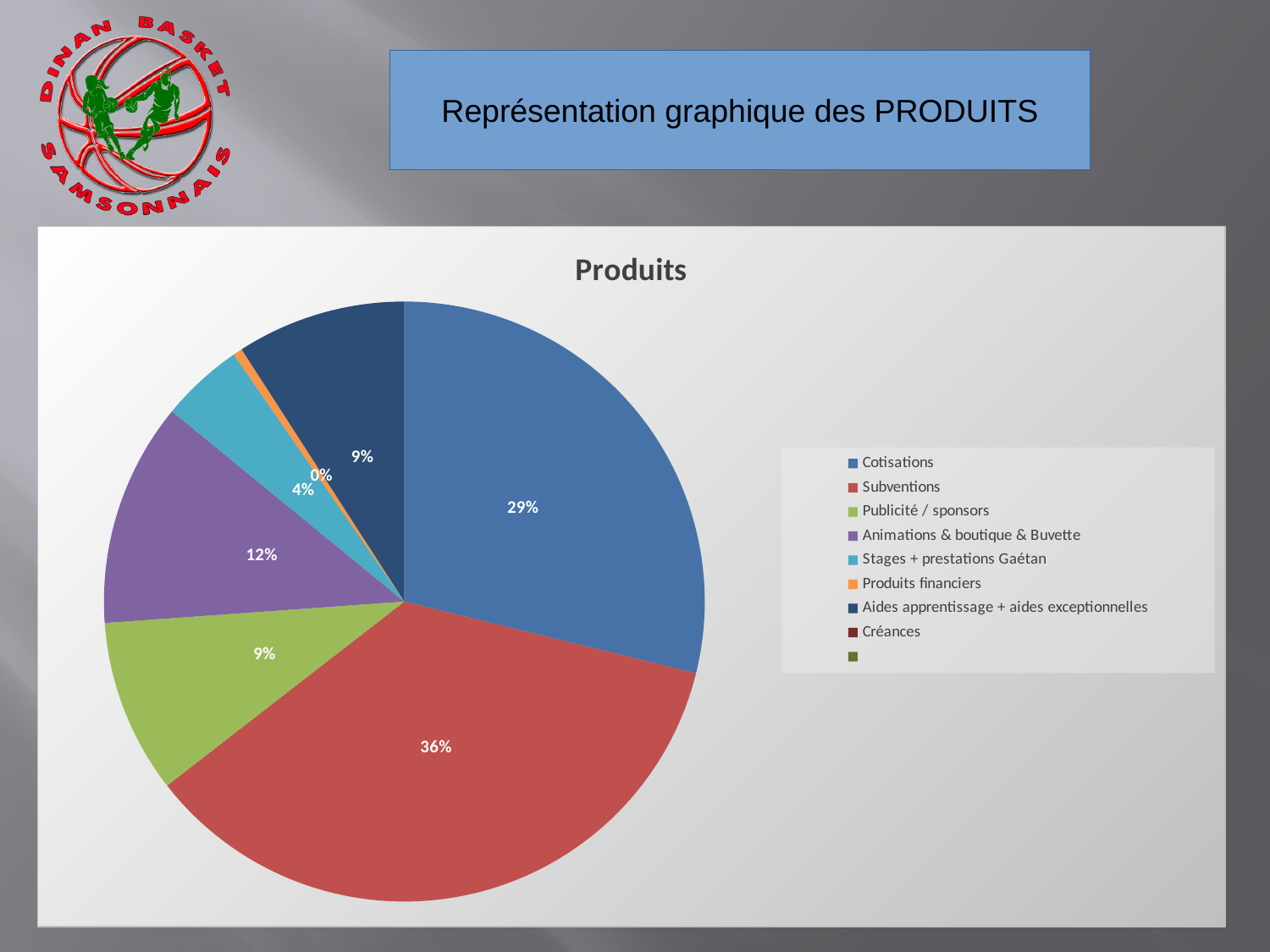
What share of the pie does Stages + prestations Gaétan represent? 4% What kind of chart is shown on the slide? Pie chart What share of the pie does Produits financiers represent? 0% Which category has the largest slice of the pie? Subventions What share of the pie does Animations & boutique & Buvette represent? 12% Which is larger, the share for Animations & boutique & Buvette or the share for Publicité / sponsors? Animations & boutique & Buvette By how many percentage points does the Subventions share exceed the Cotisations share? 7 percentage points Which is larger, the share for Cotisations or the share for Subventions? Subventions What is the title of the chart? Produits What is the combined share of Cotisations and Subventions? 65%